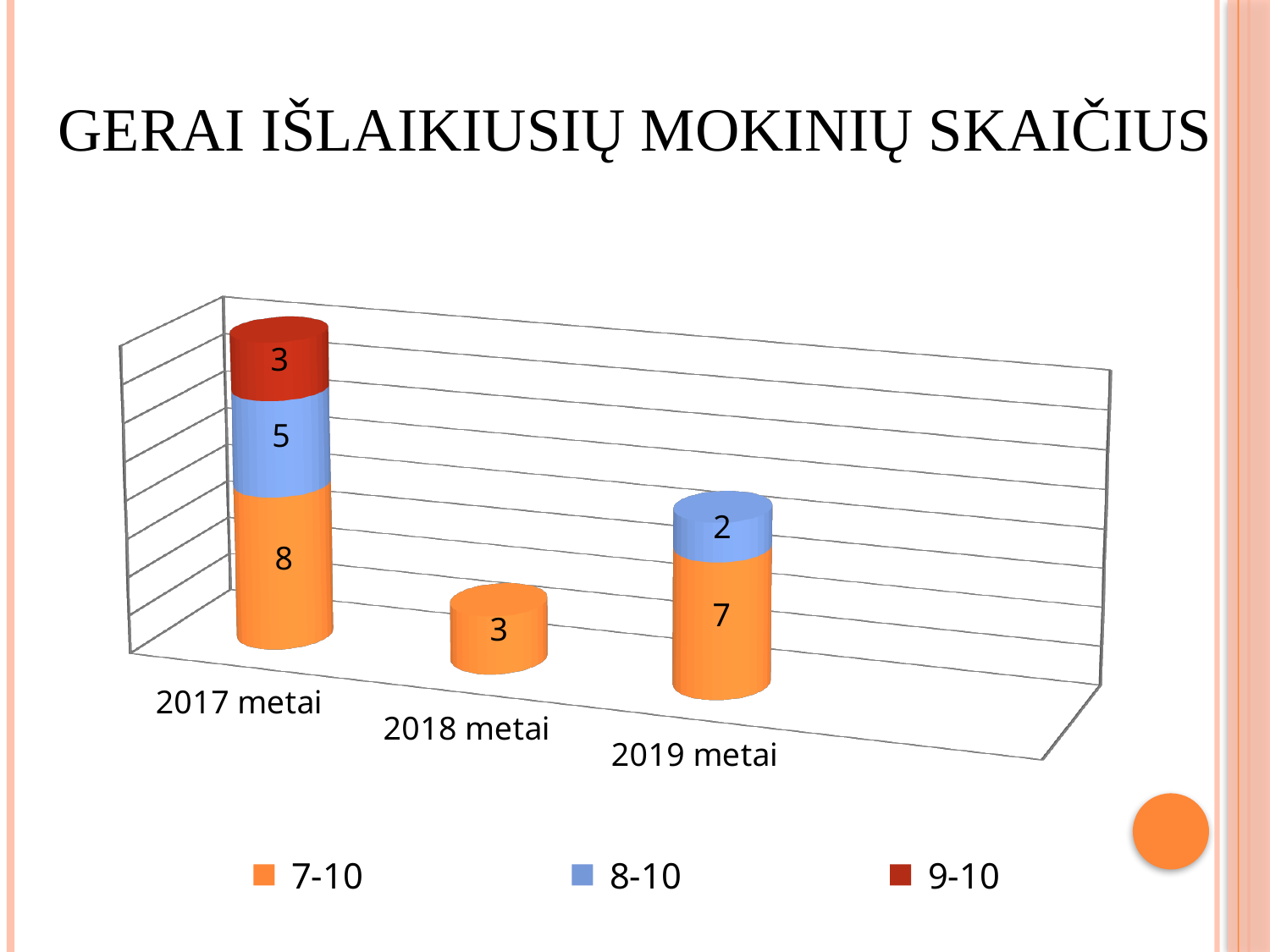
What is the total of the stacked bar for 2019 metai? 9 What kind of chart is shown on the slide? Stacked bar chart Which is larger: the 8-10 value in 2017 metai or the 8-10 value in 2019 metai? 2017 metai What is the value for the 7-10 series in 2018 metai? 3 What is the total of the stacked bar for 2017 metai? 16 What is the value for the 7-10 series in 2017 metai? 8 What is the value for the 8-10 series in 2017 metai? 5 What is the value for the 9-10 series in 2017 metai? 3 How many series does the legend list? 3 What is the value for the 8-10 series in 2019 metai? 2 Which year has the lowest total stacked bar? 2018 metai What is the difference between the 7-10 values for 2017 metai and 2019 metai? 1